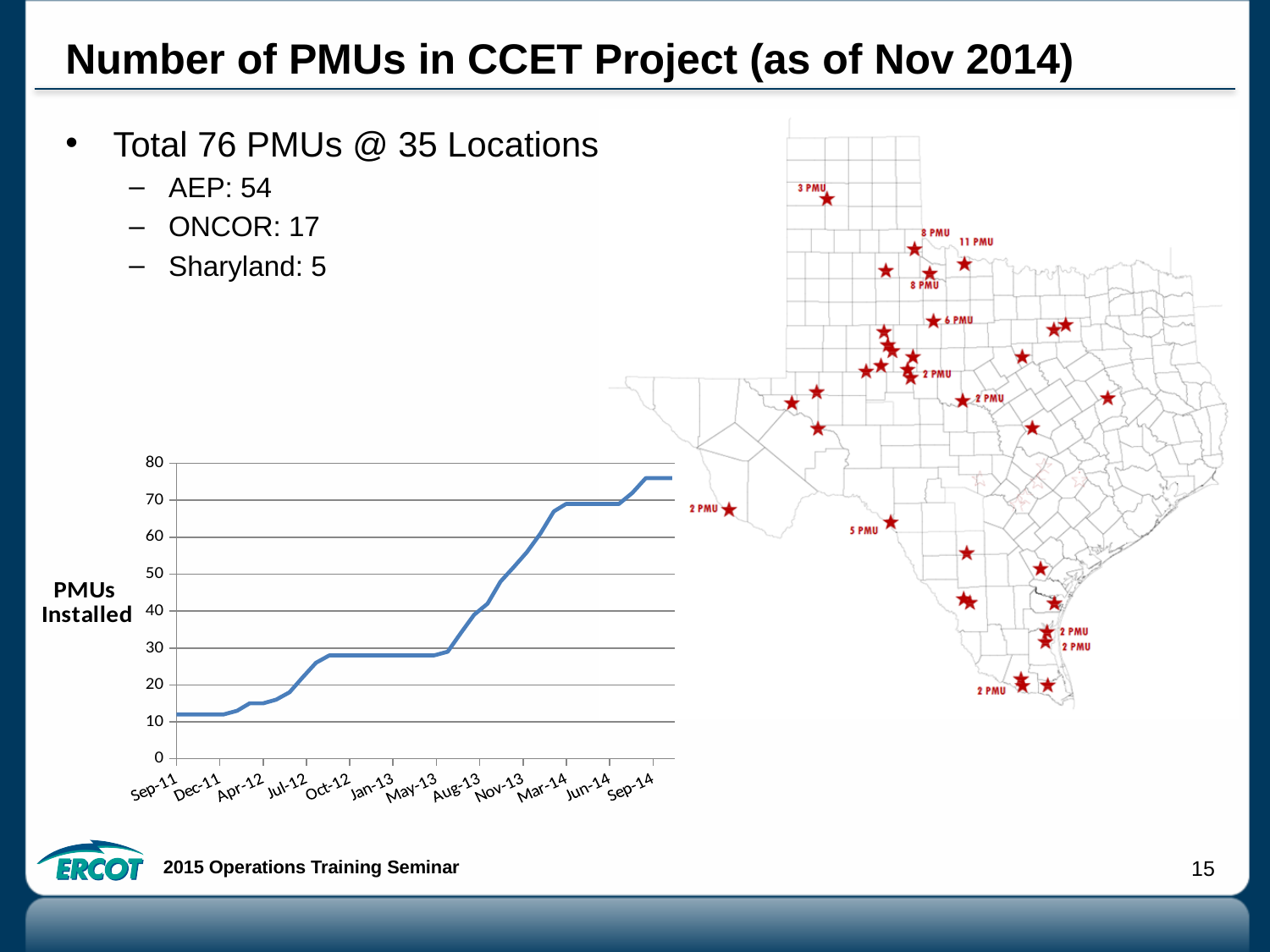
What kind of chart is shown on the slide? line chart Is the value for Jan-13 greater or less than 40? less Does the number of PMUs installed rise or fall from Sep-11 to Sep-14? rise Is the value for Jul-12 greater or less than 30? less Is the value for Mar-14 greater or less than 60? greater Which is larger, the value for Nov-13 or the value for Oct-12? Nov-13 What is the label on the vertical axis of the chart? PMUs Installed Which x-axis date has the highest number of PMUs installed? Sep-14 Which x-axis date has the lowest number of PMUs installed? Sep-11 and Dec-11 (tied) How many date labels are shown on the x axis? 12